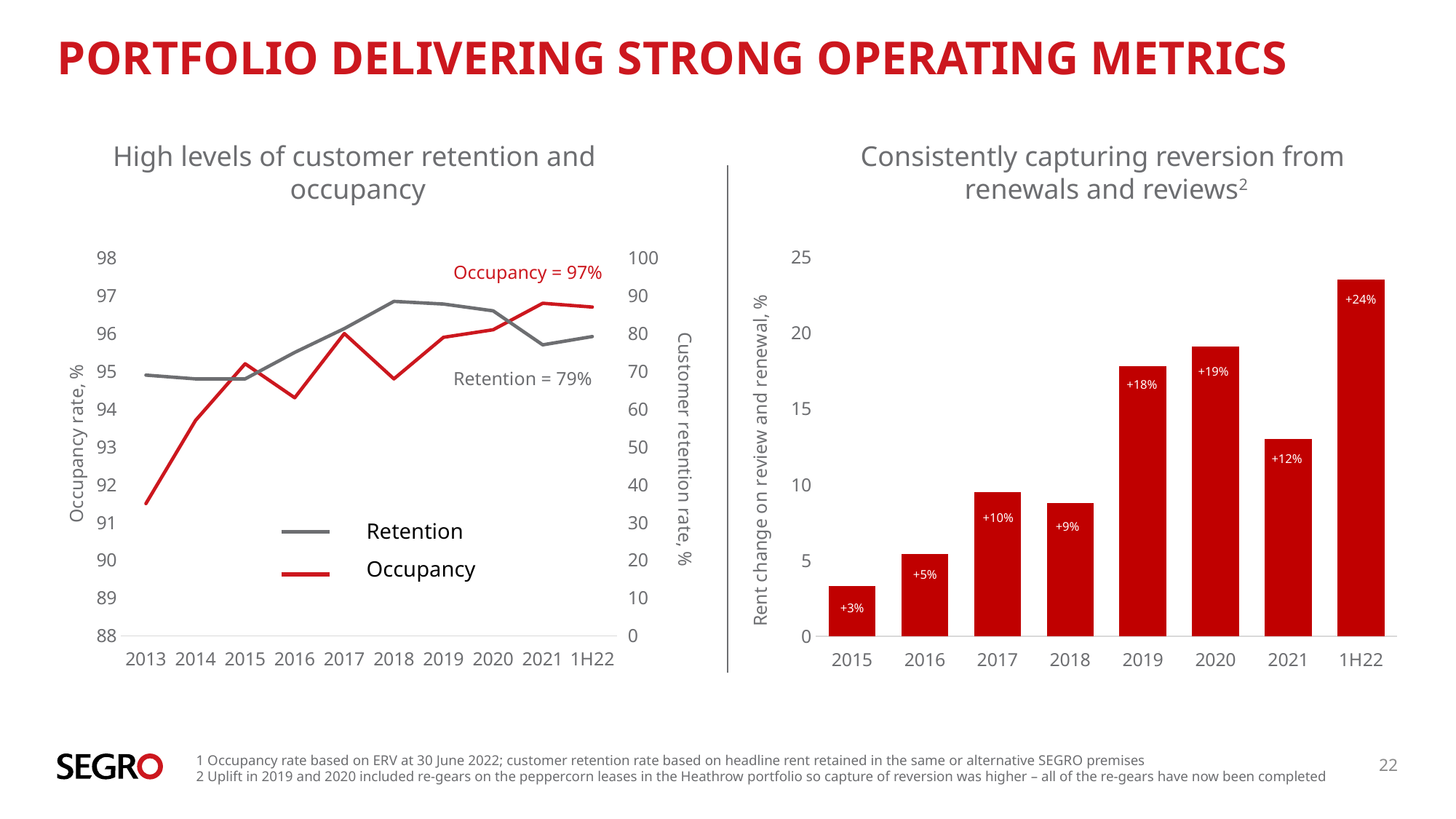
In the right-hand chart 'Consistently capturing reversion from renewals and reviews', which is larger, the rent change in 2017 or in 2018? 2017 In the right-hand chart 'Consistently capturing reversion from renewals and reviews', what is the rent change for 1H22? +24% In the right-hand chart 'Consistently capturing reversion from renewals and reviews', what is the difference between the rent change in 2020 and in 2021? 7 percentage points In the left-hand chart 'High levels of customer retention and occupancy', what is the customer retention rate at 1H22? 79% What kind of chart is the right-hand chart 'Consistently capturing reversion from renewals and reviews'? Bar chart In the left-hand chart 'High levels of customer retention and occupancy', what is the occupancy rate at 1H22? 97% In the left-hand chart 'High levels of customer retention and occupancy', how many series does the legend list? 2 In the right-hand chart 'Consistently capturing reversion from renewals and reviews', which year has the lowest rent change? 2015 In the right-hand chart 'Consistently capturing reversion from renewals and reviews', how many bars are plotted? 8 In the right-hand chart 'Consistently capturing reversion from renewals and reviews', what is the rent change for 2015? +3% In the left-hand chart 'High levels of customer retention and occupancy', is the occupancy rate in 2013 greater or less than 92? less In the right-hand chart 'Consistently capturing reversion from renewals and reviews', which year has the highest rent change? 1H22